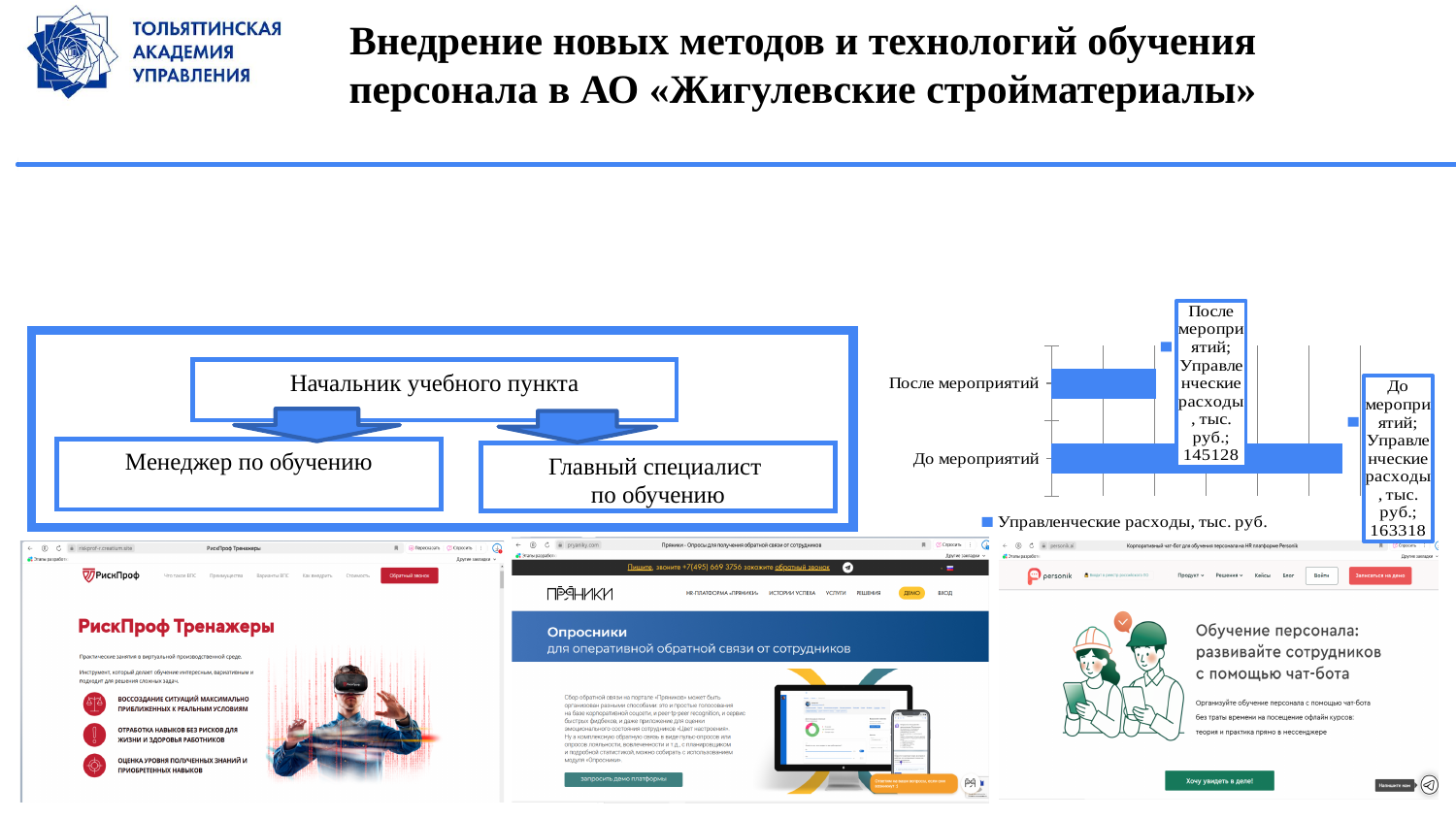
What is the value of management expenses (Управленческие расходы) for 'До мероприятий'? 163318 How many series does the chart legend list? 1 Which category has the lower value of management expenses? После мероприятий What type of chart is shown on the slide? bar chart Is the value for 'До мероприятий' larger or smaller than the value for 'После мероприятий'? larger What is the value of management expenses (Управленческие расходы) for 'После мероприятий'? 145128 What is the name of the series shown in the chart legend? Управленческие расходы, тыс. руб. By how much do management expenses differ between 'До мероприятий' and 'После мероприятий'? 18190 Which category has the higher value of management expenses? До мероприятий How many categories are plotted in the chart? 2 In what units are the management expenses in the chart expressed? тыс. руб.